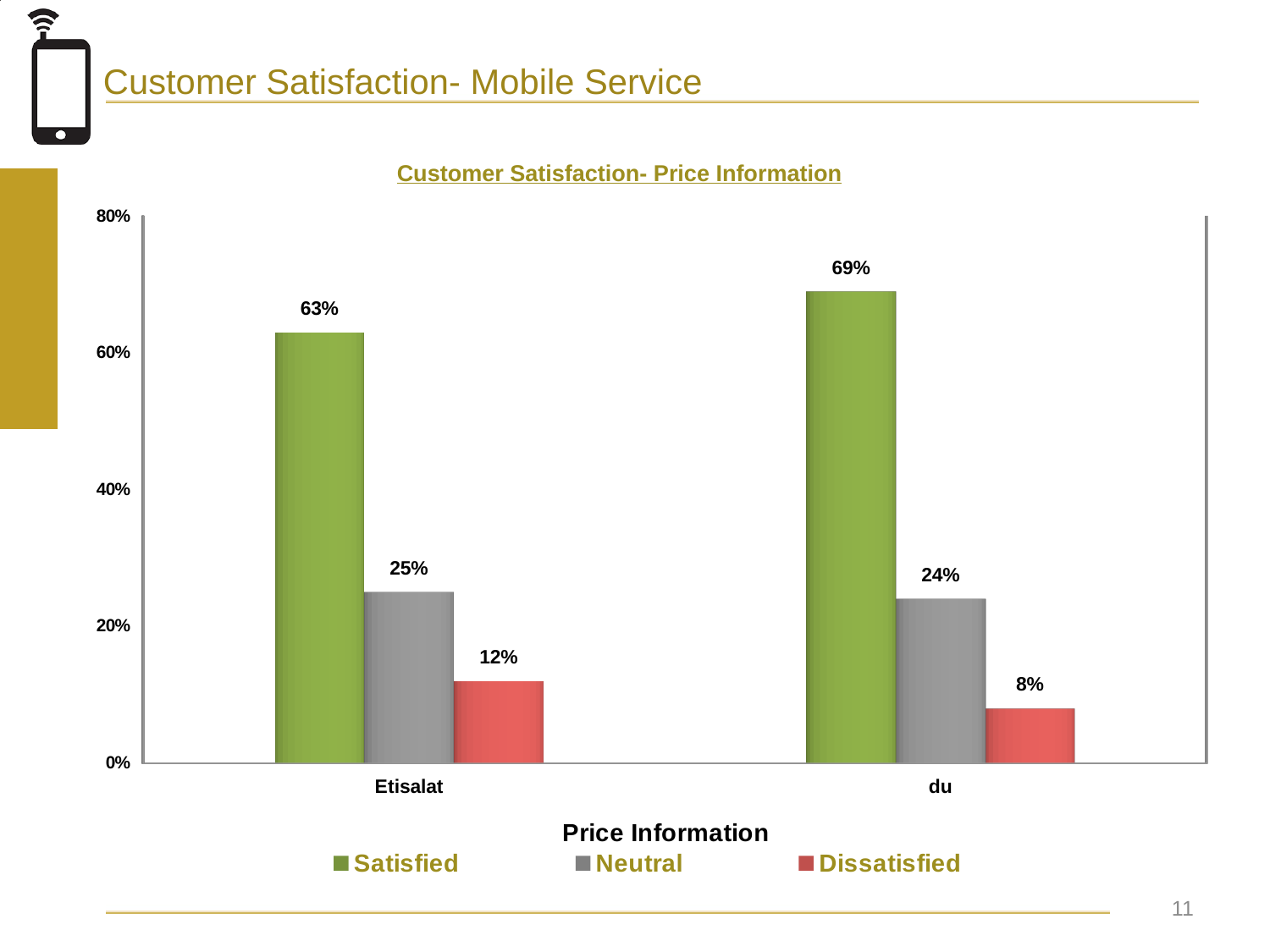
What is the Neutral value for Etisalat? 25% What is the title of the chart? Customer Satisfaction- Price Information What is the difference between the Dissatisfied percentages for Etisalat and du? 4% How many providers are shown on the x axis? 2 Which provider has the lower Dissatisfied percentage? du Which provider has the higher Satisfied percentage? du What percentage of Etisalat customers are Satisfied with price information? 63% Is the Satisfied value for du greater or less than 60%? greater What is the Dissatisfied value for du? 8% How many series does the legend list? 3 What is the difference between the Satisfied percentages for du and Etisalat? 6% What kind of chart is shown? bar chart